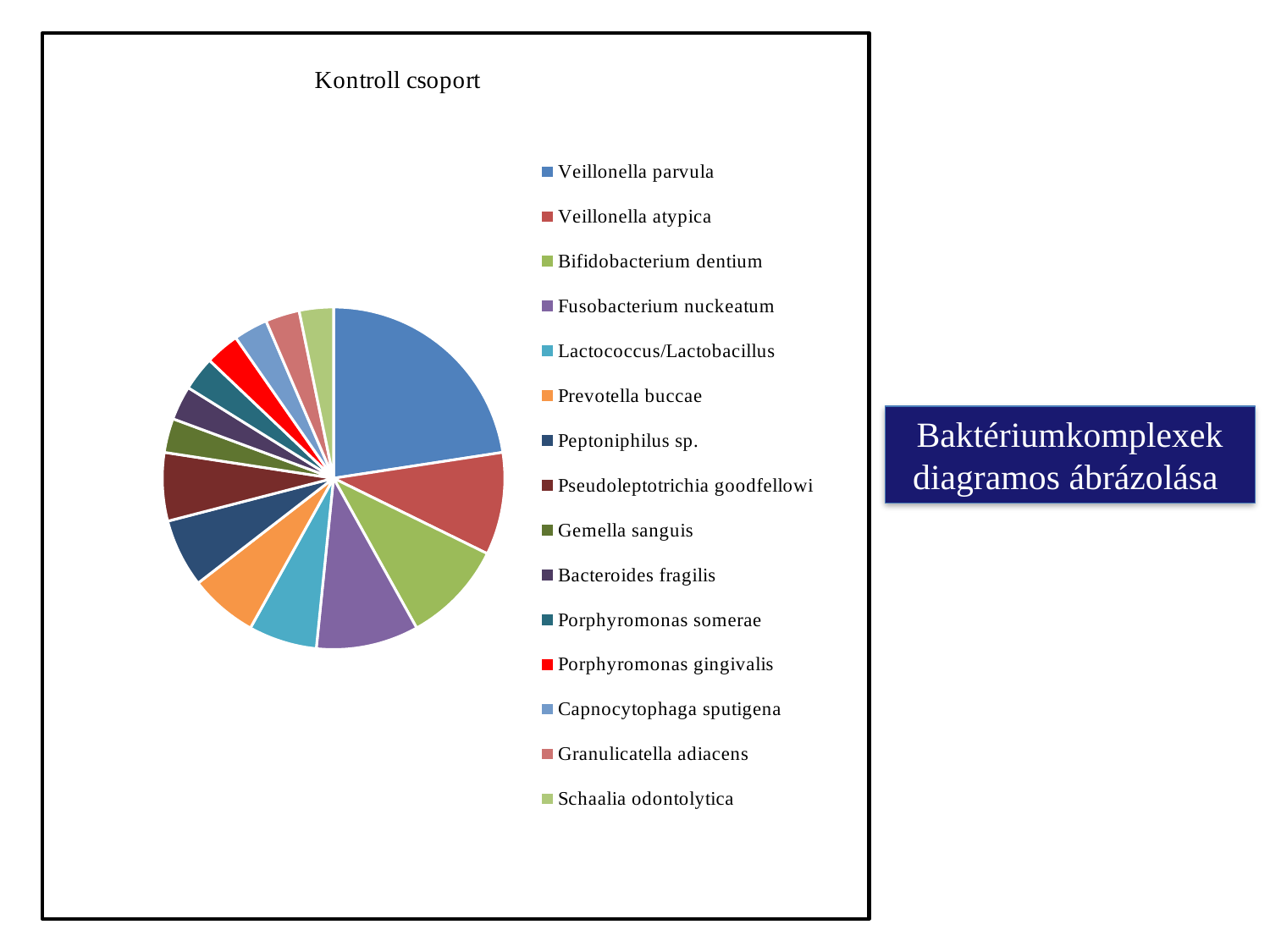
Which slice is larger, Veillonella atypica or Schaalia odontolytica? Veillonella atypica How many categories (slices) does the pie chart have? 15 Which category has the largest slice in the pie chart? Veillonella parvula What is the title of the pie chart? Kontroll csoport Which slice is larger, Fusobacterium nuckeatum or Capnocytophaga sputigena? Fusobacterium nuckeatum Which colour represents Porphyromonas gingivalis in the pie chart? Red What kind of chart is shown on the slide? Pie chart Which slice is larger, Veillonella parvula or Veillonella atypica? Veillonella parvula